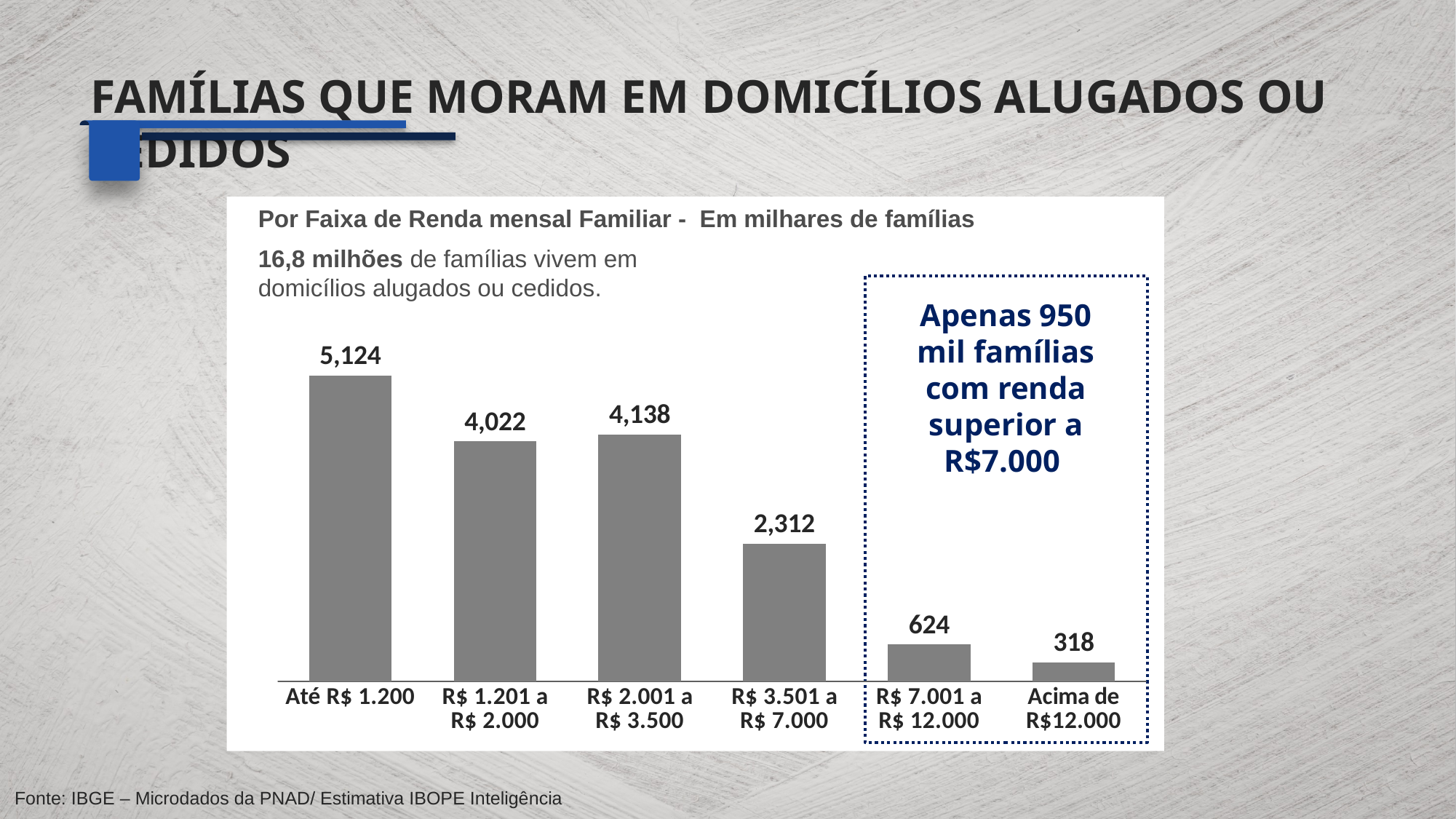
In what unit are the chart values expressed, according to the chart subtitle? Milhares de famílias Which income bracket has the highest value? Até R$ 1.200 What is the value for the 'Até R$ 1.200' income bracket? 5,124 Which is larger: the value for 'R$ 2.001 a R$ 3.500' or the value for 'R$ 1.201 a R$ 2.000'? R$ 2.001 a R$ 3.500 How many income brackets are shown in the chart? 6 What is the value for the 'R$ 3.501 a R$ 7.000' income bracket? 2,312 Which income bracket has the lowest value? Acima de R$12.000 What is the value for the 'Acima de R$12.000' income bracket? 318 What is the difference between the values for 'R$ 2.001 a R$ 3.500' and 'R$ 1.201 a R$ 2.000'? 116 What kind of chart is shown on the slide? Bar chart What is the value for the 'R$ 7.001 a R$ 12.000' income bracket? 624 What is the difference between the values for 'Até R$ 1.200' and 'R$ 1.201 a R$ 2.000'? 1,102